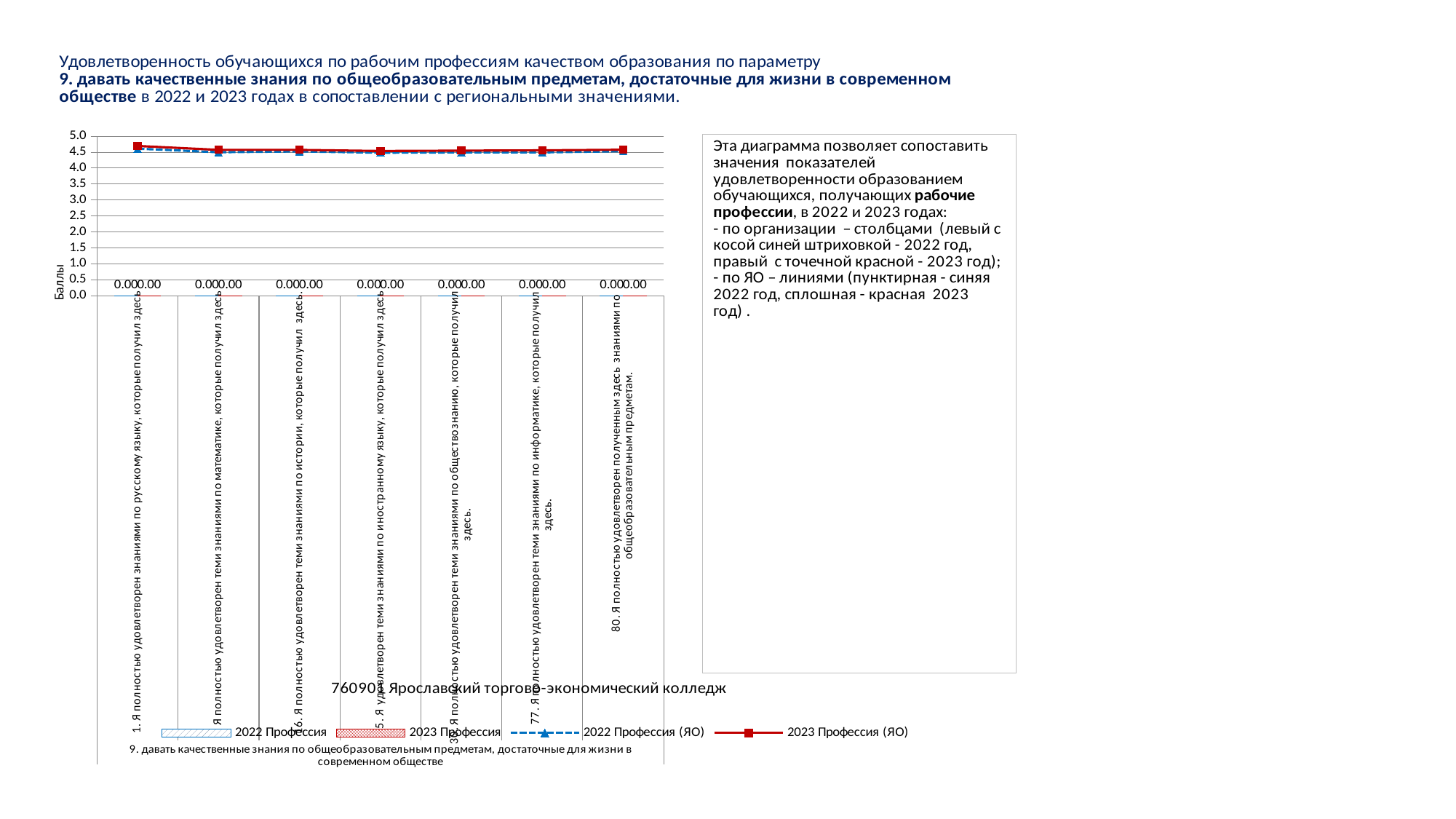
Is the value of the 2023 Профессия (ЯО) line for the last category greater or less than 1.0? greater Which series in the legend is drawn as a solid red line with square markers? 2023 Профессия (ЯО) What is the data label value of the 2022 Профессия bar for the first category (1. Я полностью удовлетворен знаниями по русскому языку...)? 0.00 What is the maximum value shown on the vertical axis of the chart? 5.0 What is the data label value of the 2023 Профессия bar for the last category (80. Я полностью удовлетворен полученным здесь знаниями по общеобразовательным предметам.)? 0.00 For the first category, which line is higher: 2022 Профессия (ЯО) or 2023 Профессия (ЯО)? 2023 Профессия (ЯО) What is the label of the vertical axis of the chart? Баллы Is the value of the 2022 Профессия (ЯО) line for the category about mathematics (2. ...по математике) greater or less than 3.5? greater How many series does the chart legend list? 4 How many categories are shown on the x axis of the chart? 7 What kind of chart is shown on the slide? Combined bar and line chart Is the value of the 2023 Профессия (ЯО) line for the first category greater or less than 4.0? greater